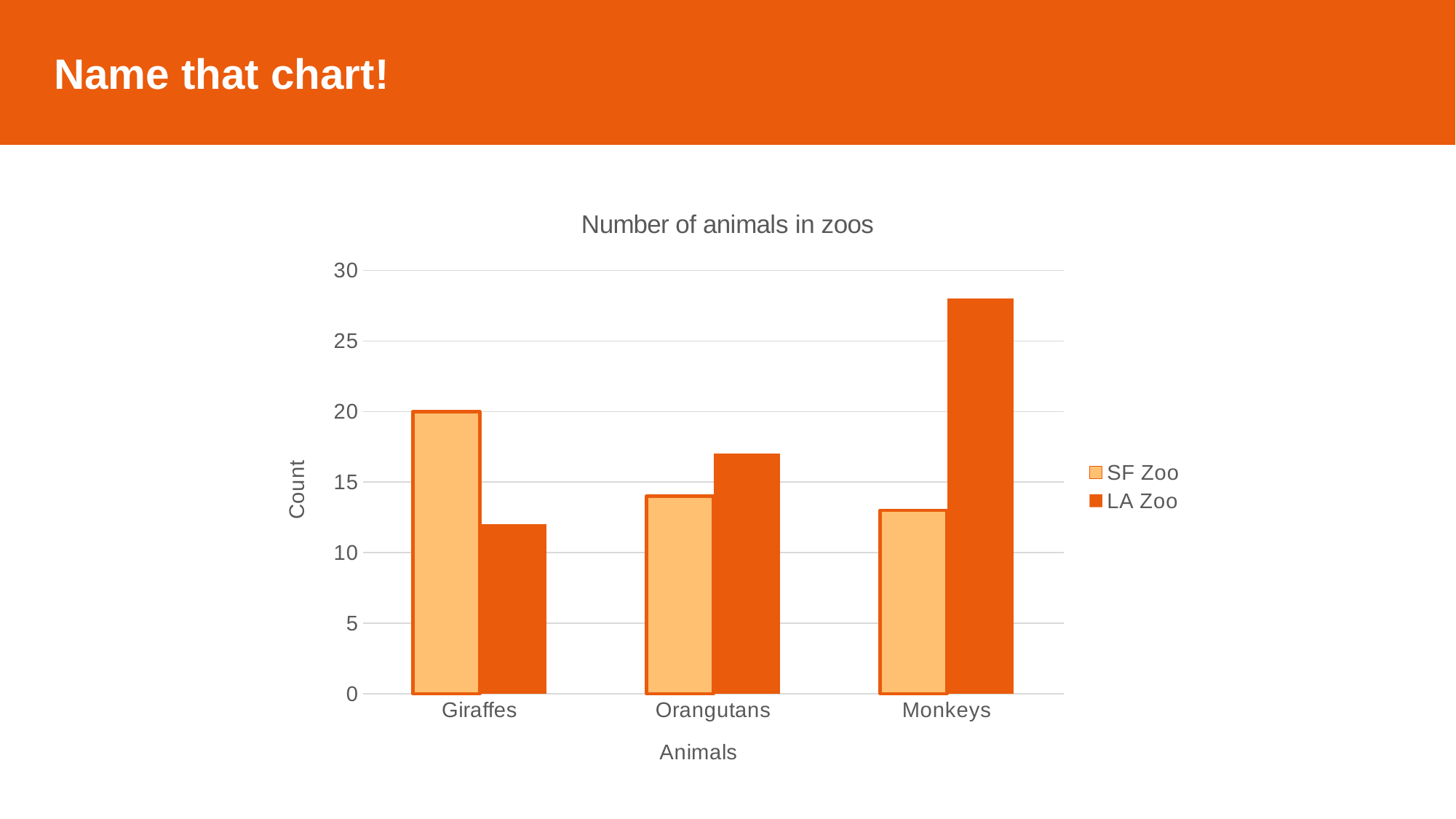
Which animal has the highest SF Zoo count? Giraffes Which animal has the lowest LA Zoo count? Giraffes How many animal categories are shown on the x axis? 3 What is the SF Zoo count for Giraffes? 20 Which animal has the highest LA Zoo count? Monkeys Is the LA Zoo value for Giraffes greater or less than 15? less What is the title of the chart? Number of animals in zoos How many series does the legend list? 2 What type of chart is shown on the slide? bar chart For Monkeys, which zoo has the larger count, SF Zoo or LA Zoo? LA Zoo Is the LA Zoo value for Monkeys greater or less than 25? greater For Giraffes, which zoo has the larger count, SF Zoo or LA Zoo? SF Zoo